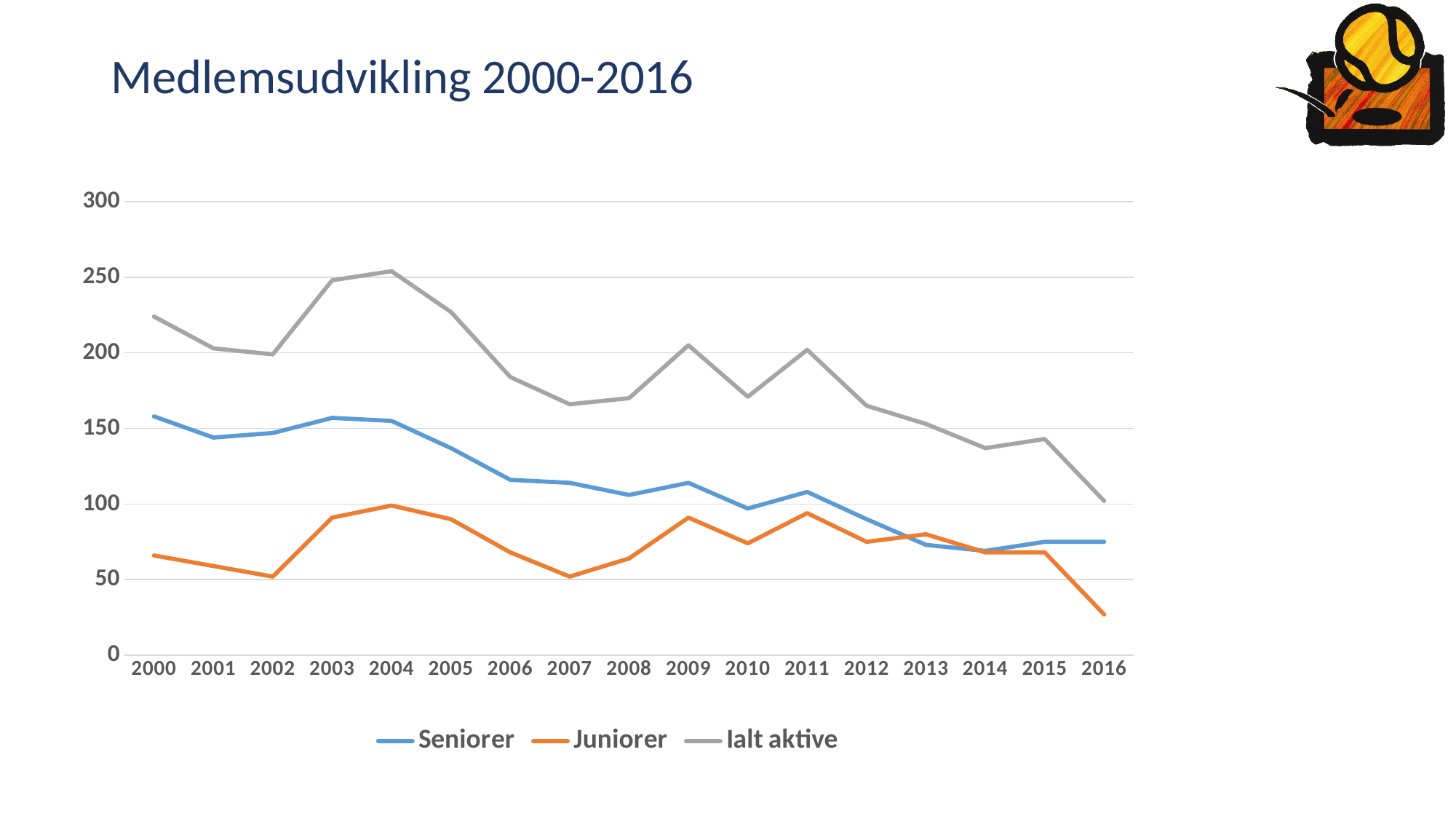
How many years are plotted along the x axis? 17 In which year does the Ialt aktive series reach its lowest value? 2016 Is the value for Juniorer in 2016 greater or less than 50? less What is the title of the slide? Medlemsudvikling 2000-2016 In which year does the Ialt aktive series reach its highest value? 2004 In which year does the Juniorer series reach its lowest value? 2016 Does the Ialt aktive series overall rise or fall from 2000 to 2016? fall Is the value for Ialt aktive in 2016 greater or less than 150? less Is the value for Ialt aktive in 2000 greater or less than 200? greater What kind of chart is shown on the slide? line chart In 2000, which series has the larger value, Seniorer or Juniorer? Seniorer How many series does the legend list? 3